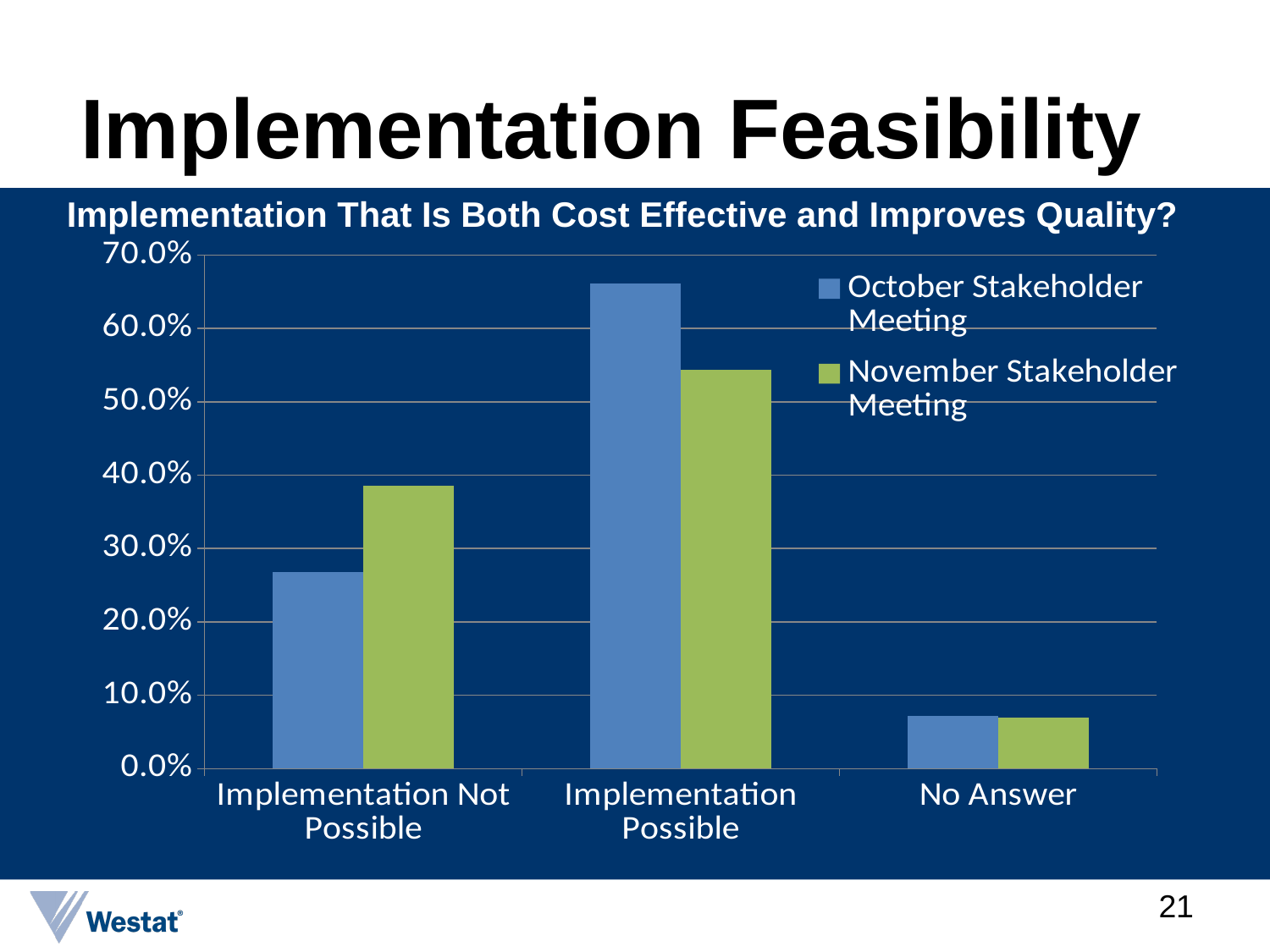
Which series is shown in green? November Stakeholder Meeting Is the October Stakeholder Meeting value for Implementation Possible greater or less than 60.0%? greater What is the title of the chart? Implementation That Is Both Cost Effective and Improves Quality? Which category has the lowest value for the November Stakeholder Meeting? No Answer For Implementation Possible, which meeting has the larger value, October or November? October Stakeholder Meeting For Implementation Not Possible, which meeting has the larger value, October or November? November Stakeholder Meeting What kind of chart is shown on the slide? bar chart Is the October Stakeholder Meeting value for No Answer greater or less than 10.0%? less Which category has the highest value for the October Stakeholder Meeting? Implementation Possible How many categories are shown on the x axis? 3 How many series does the legend list? 2 Is the November Stakeholder Meeting value for Implementation Not Possible greater or less than 40.0%? less